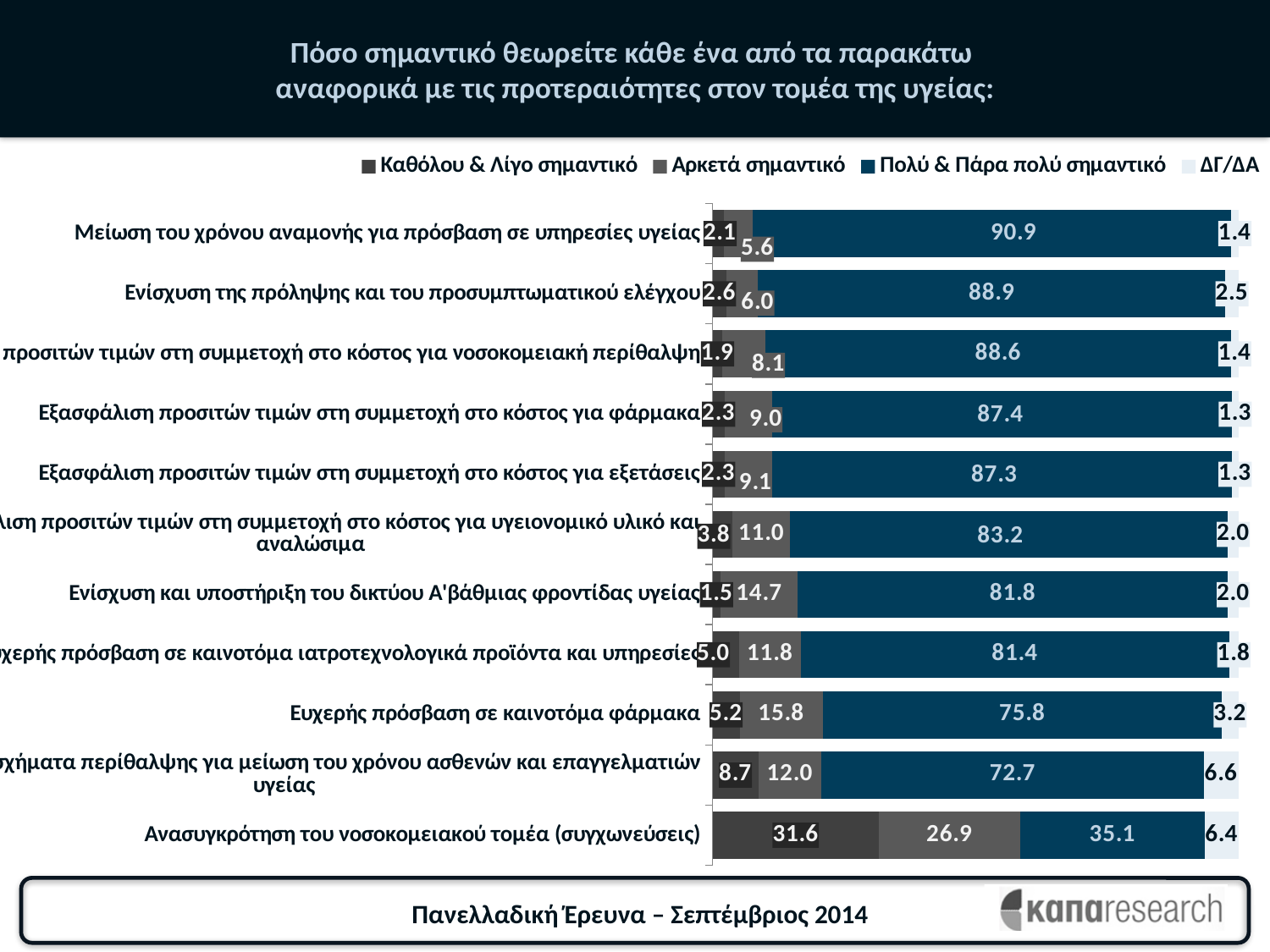
What is the difference between the 'Πολύ & Πάρα πολύ σημαντικό' values for 'Εξασφάλιση προσιτών τιμών στη συμμετοχή στο κόστος για φάρμακα' and 'Ευχερής πρόσβαση σε καινοτόμα φάρμακα'? 11.6 What is the 'Καθόλου & Λίγο σημαντικό' value for 'Ανασυγκρότηση του νοσοκομειακού τομέα (συγχωνεύσεις)'? 31.6 What is the total of the stacked bar for 'Ανασυγκρότηση του νοσοκομειακού τομέα (συγχωνεύσεις)'? 100.0 What type of chart is shown on the slide? Stacked bar chart What is the 'Πολύ & Πάρα πολύ σημαντικό' value for 'Μείωση του χρόνου αναμονής για πρόσβαση σε υπηρεσίες υγείας'? 90.9 How many series does the legend list? 4 Which category has the highest 'Πολύ & Πάρα πολύ σημαντικό' value? Μείωση του χρόνου αναμονής για πρόσβαση σε υπηρεσίες υγείας What is the 'ΔΓ/ΔΑ' value for 'Ενίσχυση της πρόληψης και του προσυμπτωματικού ελέγχου'? 2.5 What is the 'Αρκετά σημαντικό' value for 'Ευχερής πρόσβαση σε καινοτόμα φάρμακα'? 15.8 Which category has the lowest 'Πολύ & Πάρα πολύ σημαντικό' value? Ανασυγκρότηση του νοσοκομειακού τομέα (συγχωνεύσεις) How many categories (health priorities) are plotted in the chart? 11 Which has a larger 'Αρκετά σημαντικό' value: 'Ενίσχυση και υποστήριξη του δικτύου Α'βάθμιας φροντίδας υγείας' or 'Εξασφάλιση προσιτών τιμών στη συμμετοχή στο κόστος για εξετάσεις'? Ενίσχυση και υποστήριξη του δικτύου Α'βάθμιας φροντίδας υγείας